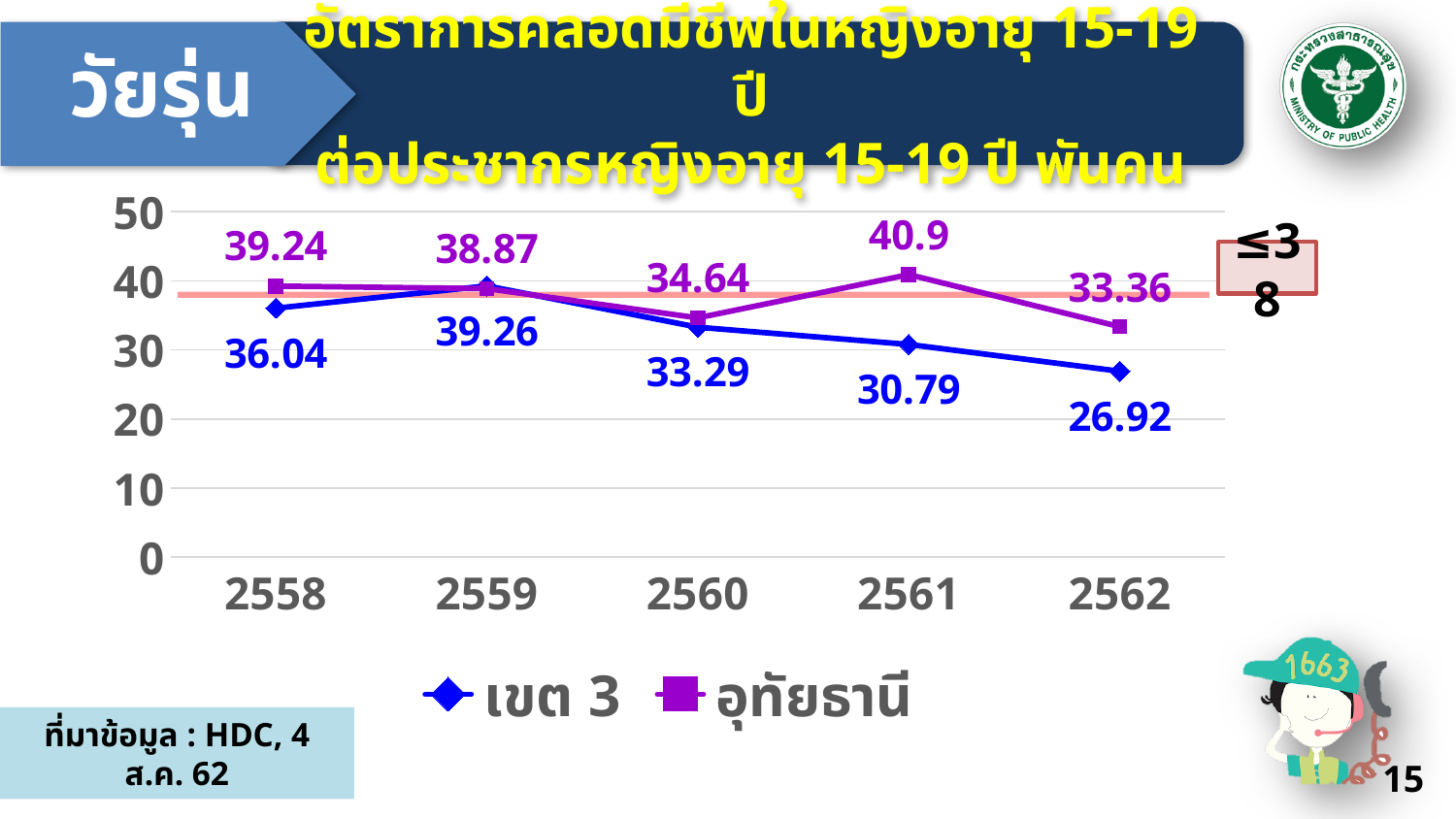
What is the difference between อุทัยธานี and เขต 3 in 2561? 10.11 Does the value for เขต 3 rise or fall from 2559 to 2562? fall What is the value for เขต 3 in 2558? 36.04 What is the value for เขต 3 in 2562? 26.92 What is the value for อุทัยธานี in 2561? 40.9 What kind of chart is shown on the slide? line chart How many series does the legend list? 2 What is the value for อุทัยธานี in 2560? 34.64 In which year is the value for อุทัยธานี highest? 2561 Which series has the larger value in 2562, เขต 3 or อุทัยธานี? อุทัยธานี How many years are shown on the x axis? 5 In which year is the value for เขต 3 lowest? 2562